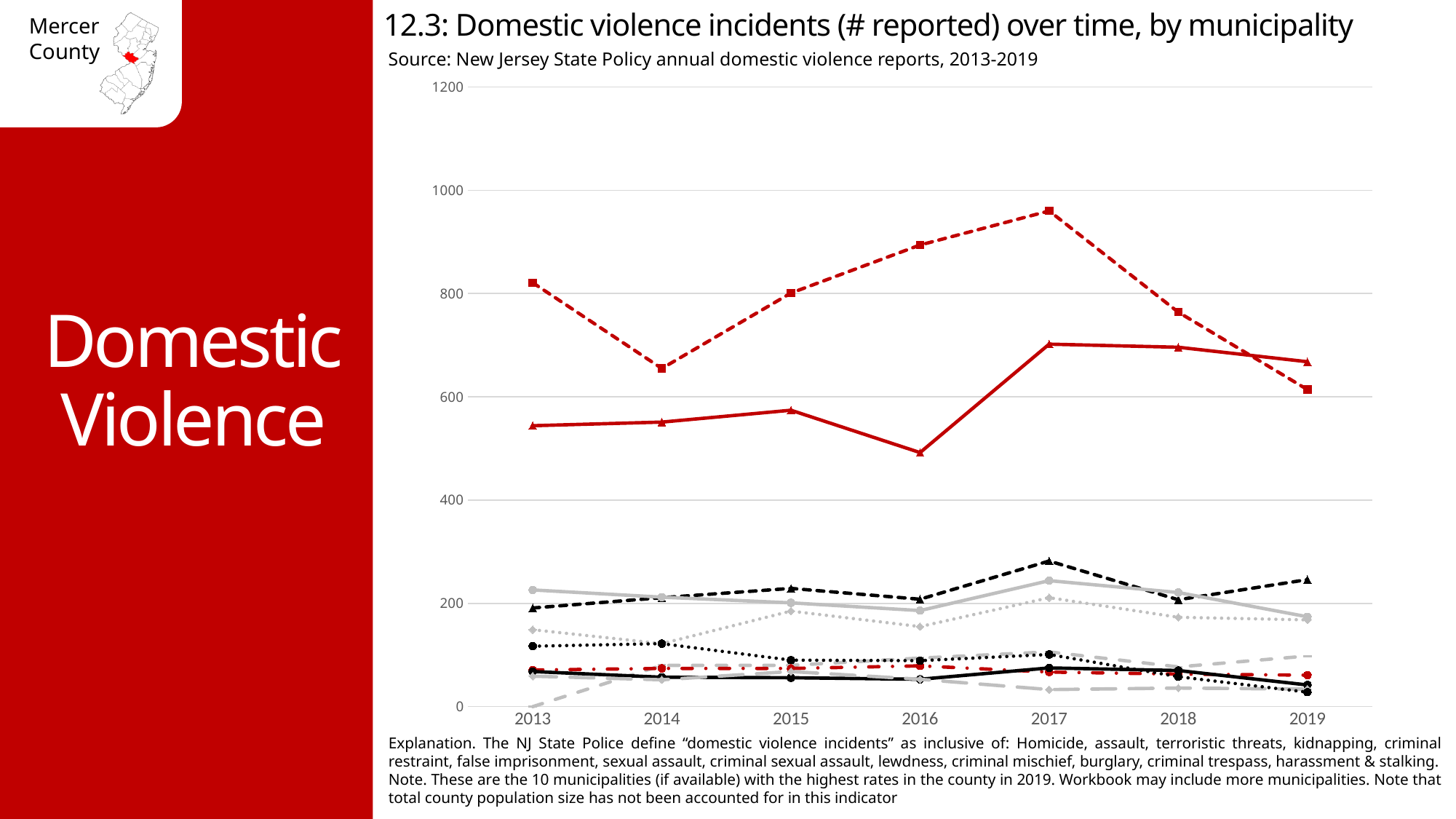
What is the title of the chart on the slide? 12.3: Domestic violence incidents (# reported) over time, by municipality Does the dashed red line with square markers rise or fall between 2017 and 2019? fall What source is cited for the chart data? New Jersey State Policy annual domestic violence reports, 2013-2019 In 2017, is the value of the highest line (dashed red line with square markers) greater or less than 800? greater What kind of chart is shown on the slide? line chart Does any line on the chart exceed 1000 incidents in any year? No In 2016, is the value of the solid red line with triangle markers greater or less than 600? less In 2019, which is higher: the solid red line with triangle markers or the dashed red line with square markers? the solid red line with triangle markers In which year does the dashed red line with square markers reach its highest value? 2017 How many years are shown along the x axis of the chart? 7 What is the first year shown on the x axis of the chart? 2013